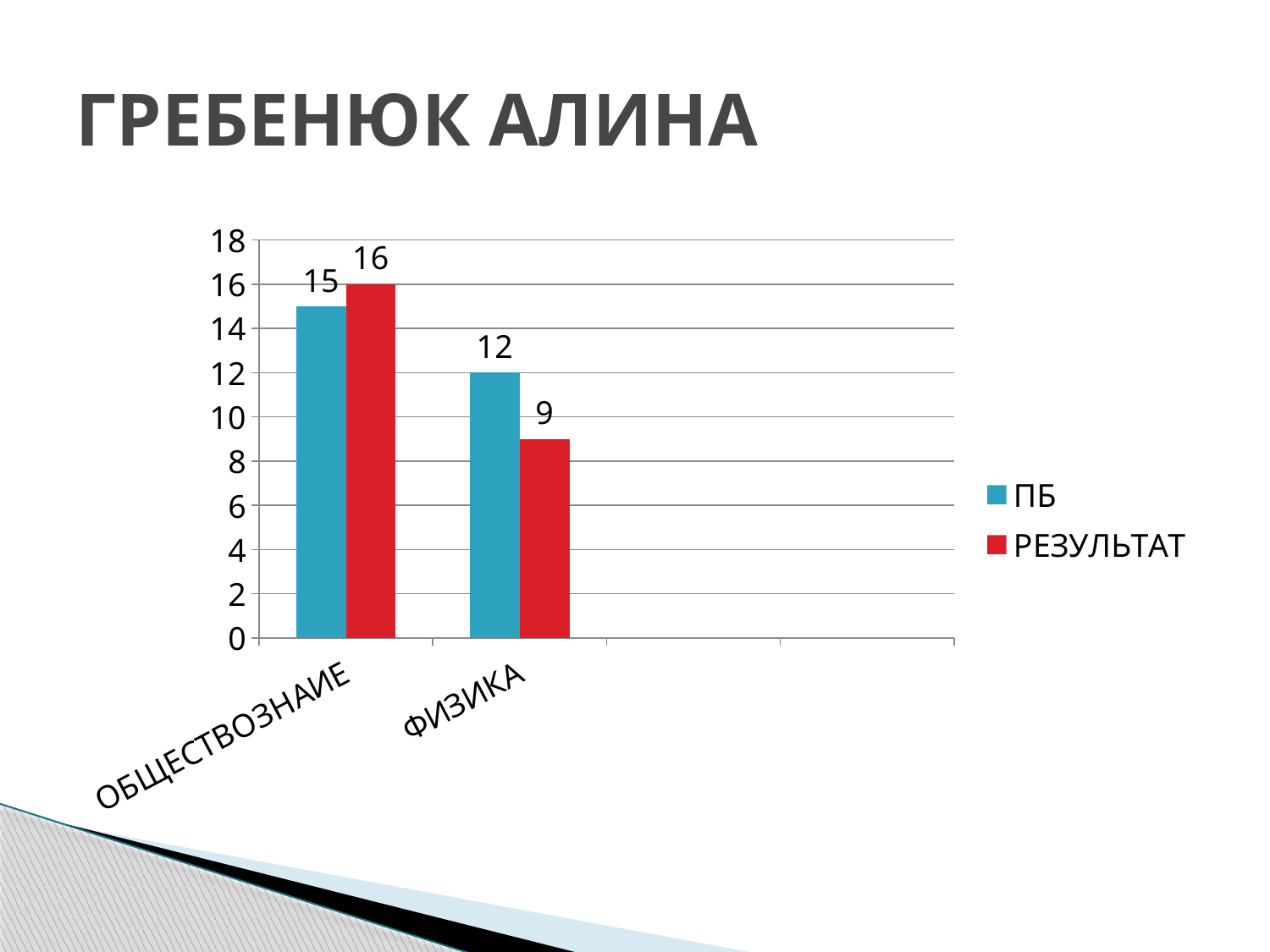
For ОБЩЕСТВОЗНАИЕ, which is larger: ПБ or РЕЗУЛЬТАТ? РЕЗУЛЬТАТ What is the ПБ value for ОБЩЕСТВОЗНАИЕ? 15 What is the ПБ value for ФИЗИКА? 12 What kind of chart is shown on the slide? Bar chart What is the difference between the РЕЗУЛЬТАТ values for ОБЩЕСТВОЗНАИЕ and ФИЗИКА? 7 What is the РЕЗУЛЬТАТ value for ФИЗИКА? 9 How many series does the legend list? 2 Which category has the highest РЕЗУЛЬТАТ value? ОБЩЕСТВОЗНАИЕ Which category has the lowest ПБ value? ФИЗИКА What is the РЕЗУЛЬТАТ value for ОБЩЕСТВОЗНАИЕ? 16 What is the difference between the ПБ and РЕЗУЛЬТАТ values for ФИЗИКА? 3 How many categories are shown on the x axis? 2